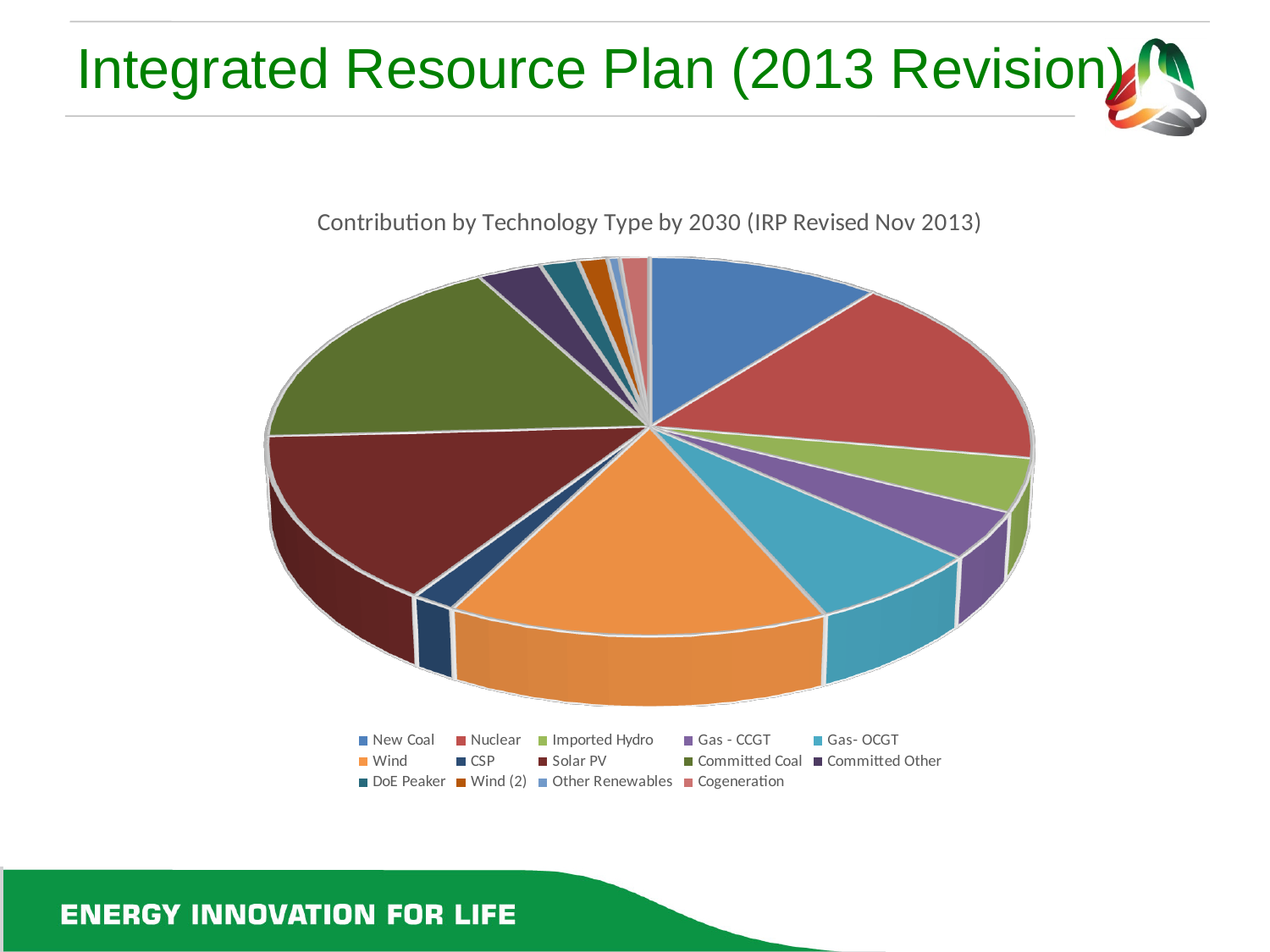
Which is larger, the slice for Solar PV or the slice for Imported Hydro? Solar PV Which is larger, the slice for Gas- OCGT or the slice for Other Renewables? Gas- OCGT Which is larger, the slice for Committed Coal or the slice for DoE Peaker? Committed Coal What colour represents Wind in the chart? Orange What kind of chart is shown on the slide? Pie chart How many technology types does the legend list? 14 What is the title of the chart? Contribution by Technology Type by 2030 (IRP Revised Nov 2013)